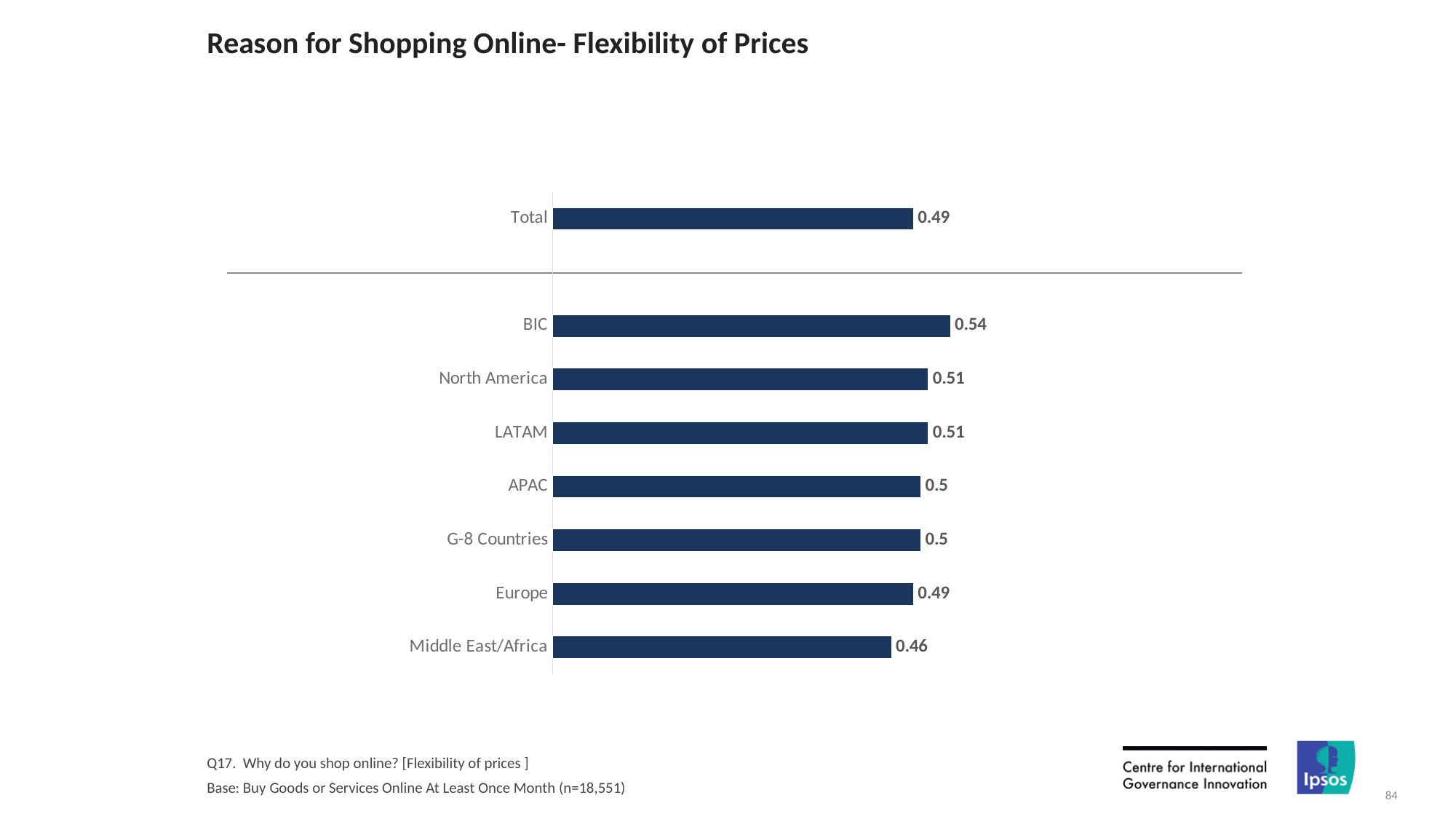
What is the difference between the values for North America and Europe? 0.02 What is the value for Total? 0.49 What is the value for G-8 Countries? 0.5 What is the value for North America? 0.51 How many categories are plotted in the chart? 8 What is the value for BIC? 0.54 Which category has the highest value? BIC What is the value for Middle East/Africa? 0.46 Which category has the lowest value? Middle East/Africa What kind of chart is shown on the slide? Bar chart What is the difference between the values for BIC and Middle East/Africa? 0.08 Which is larger, the value for BIC or the value for Europe? BIC